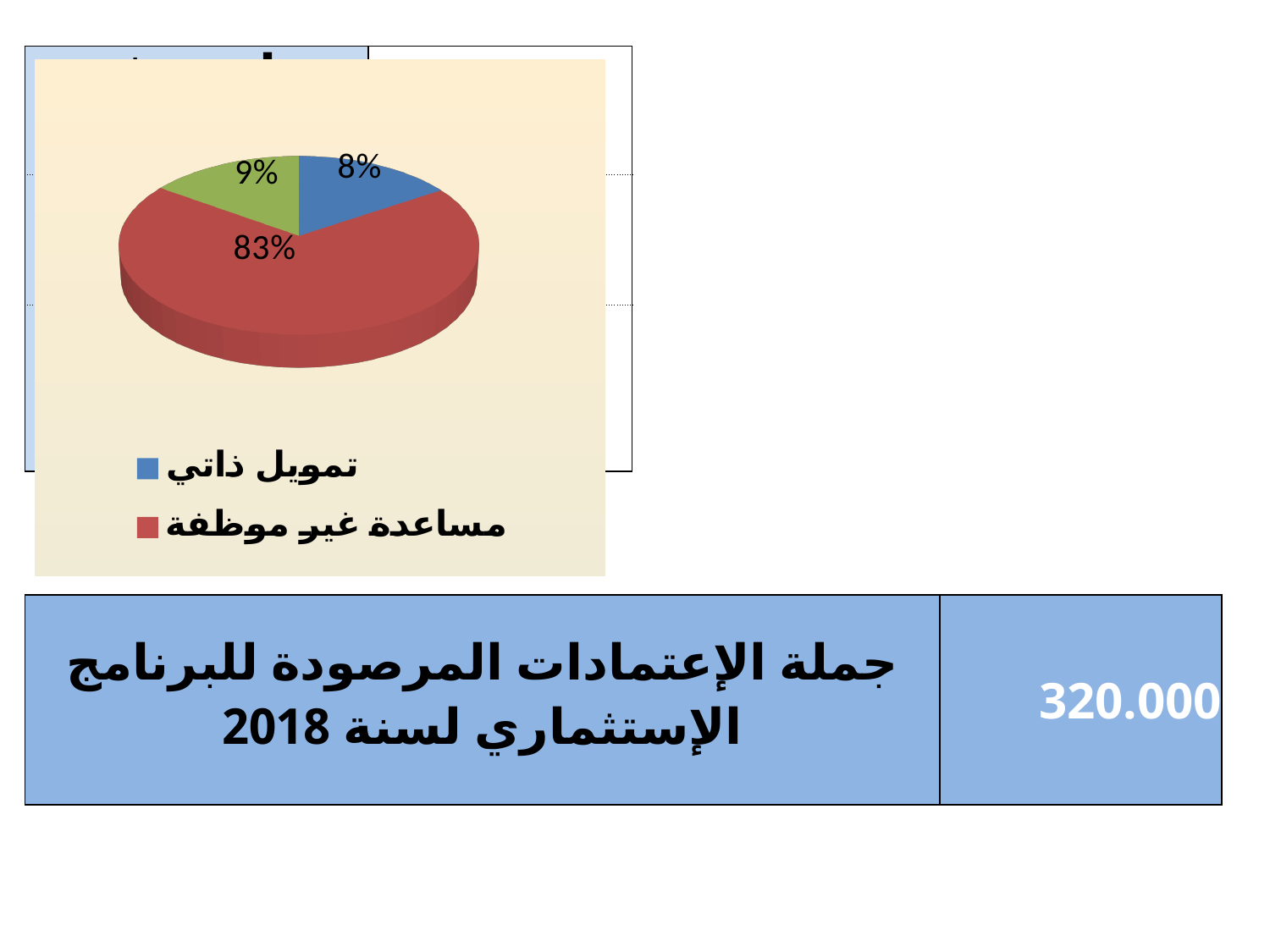
What is the smallest percentage value printed on the pie chart? 8% What is the largest percentage value printed on the pie chart? 83% Which category has the largest slice in the pie chart? مساعدة غير موظفة What percentage of the pie chart does the slice for مساعدة غير موظفة represent? 83% Which slice is larger: تمويل ذاتي or مساعدة غير موظفة? مساعدة غير موظفة How many slices does the pie chart have? 3 What kind of chart is shown on the slide? Pie chart What colour is the slice for مساعدة غير موظفة in the pie chart? Red What percentage of the pie chart does the slice for تمويل ذاتي represent? 8% What colour is the slice for تمويل ذاتي in the pie chart? Blue Which category has the smallest slice in the pie chart? تمويل ذاتي What is the difference in percentage points between the slice for مساعدة غير موظفة and the slice for تمويل ذاتي? 75%